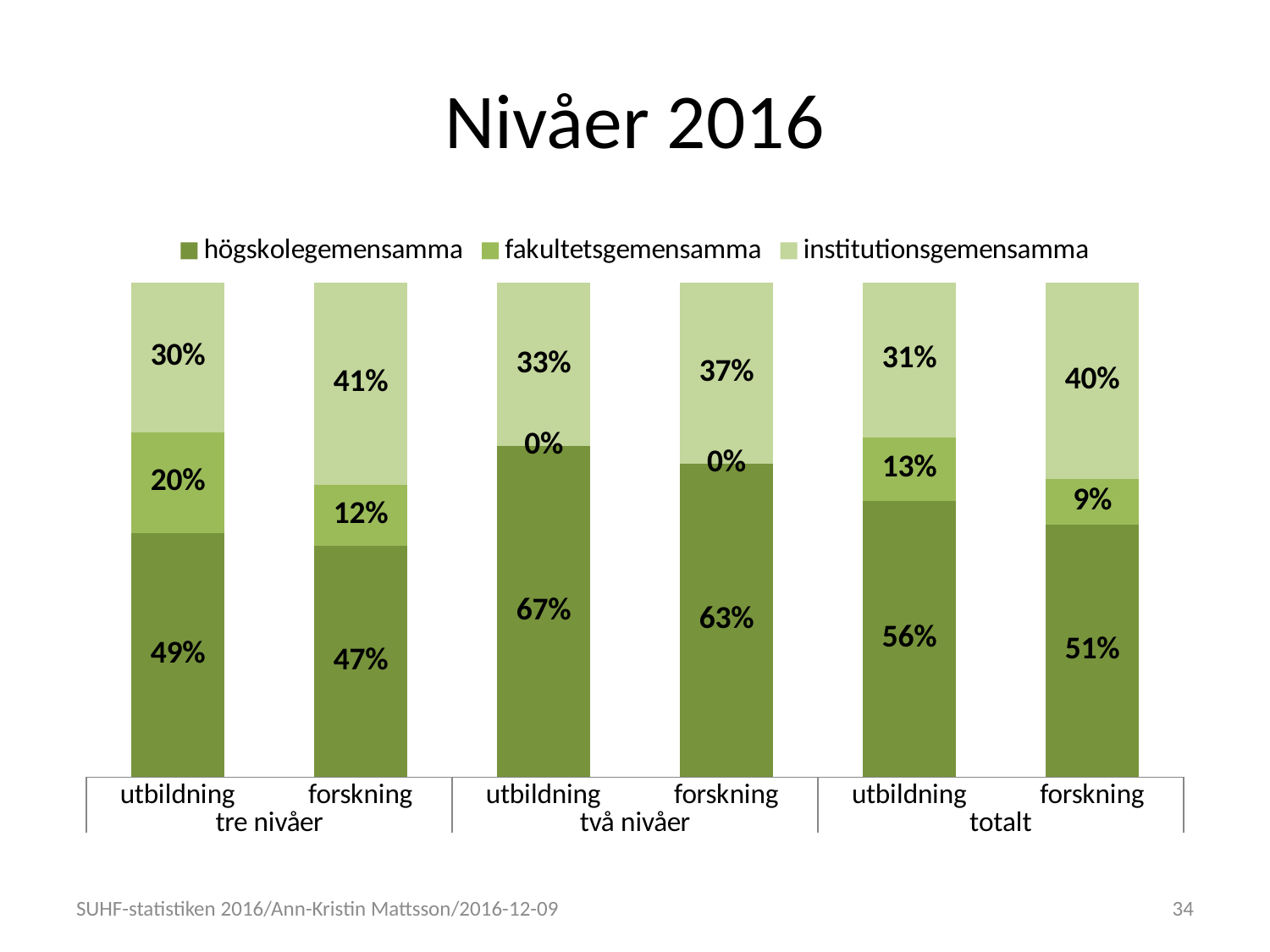
Which is larger: the institutionsgemensamma value for forskning in 'två nivåer' or for forskning in 'totalt'? forskning, totalt What is the title of the slide? Nivåer 2016 What is the högskolegemensamma value for utbildning in the 'tre nivåer' group? 49% What is the institutionsgemensamma value for forskning in the 'tre nivåer' group? 41% What is the difference between the fakultetsgemensamma values for utbildning and forskning in the 'totalt' group? 4% What is the högskolegemensamma value for forskning in the 'totalt' group? 51% How many bars are plotted in the chart? 6 What is the fakultetsgemensamma value for utbildning in the 'två nivåer' group? 0% What kind of chart is shown on the slide? stacked bar chart Which bar has the lowest institutionsgemensamma value? utbildning, tre nivåer How many series does the legend list? 3 Which bar has the highest högskolegemensamma value? utbildning, två nivåer